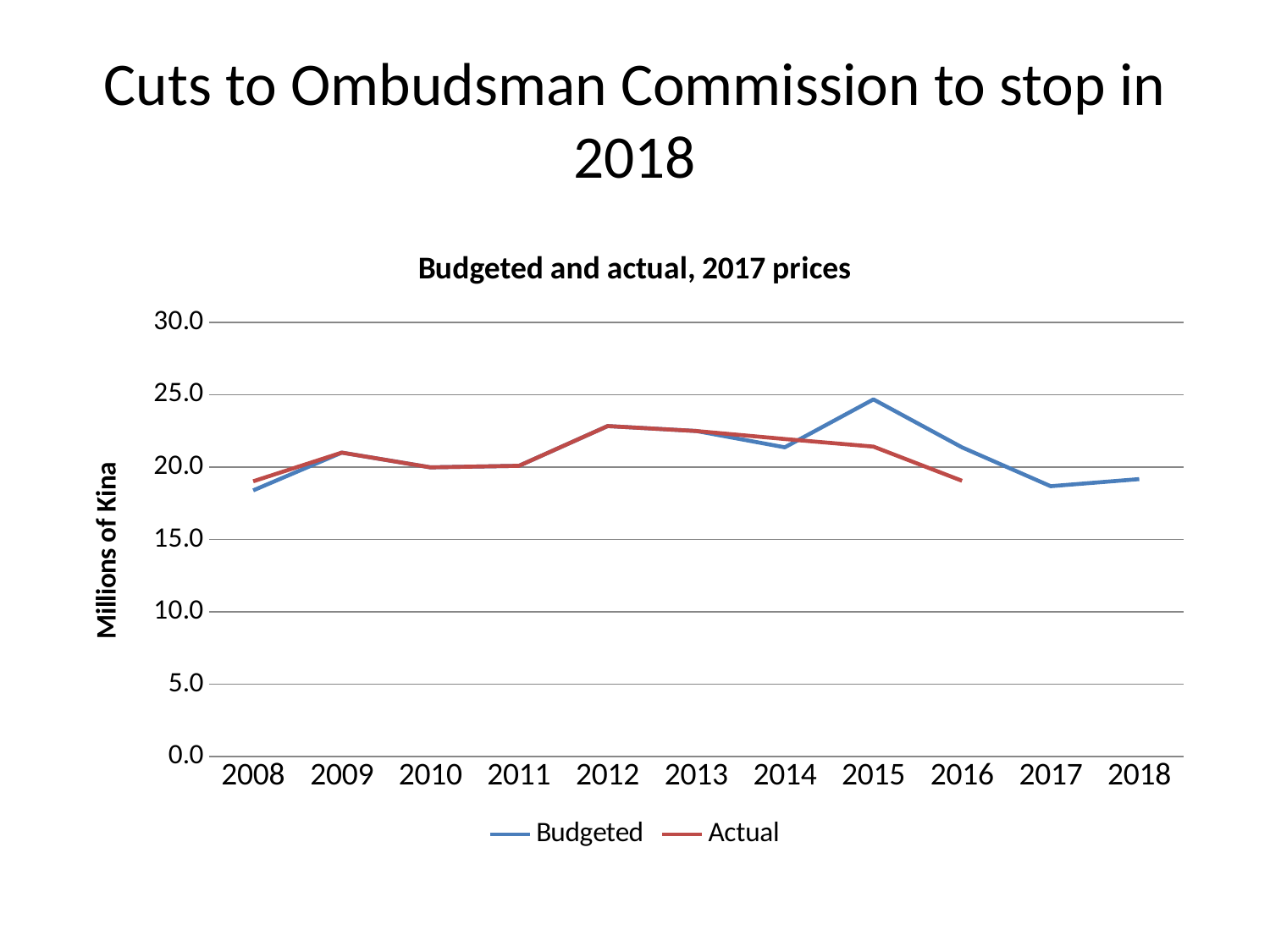
Does the Actual series rise or fall between 2012 and 2016? Fall What is the title of the chart? Budgeted and actual, 2017 prices What is the label on the vertical axis? Millions of Kina Is the Actual value for 2016 greater or less than 20.0? less What kind of chart is shown on the slide? Line chart How many series does the legend list? 2 Is the Budgeted value for 2008 greater or less than 20.0? less Is the Budgeted value for 2015 greater or less than 20.0? greater In which year does the Budgeted series reach its highest value? 2015 How many years are shown along the x axis? 11 What is the last year for which the Actual series has a data point? 2016 In 2015, which series has the larger value, Budgeted or Actual? Budgeted